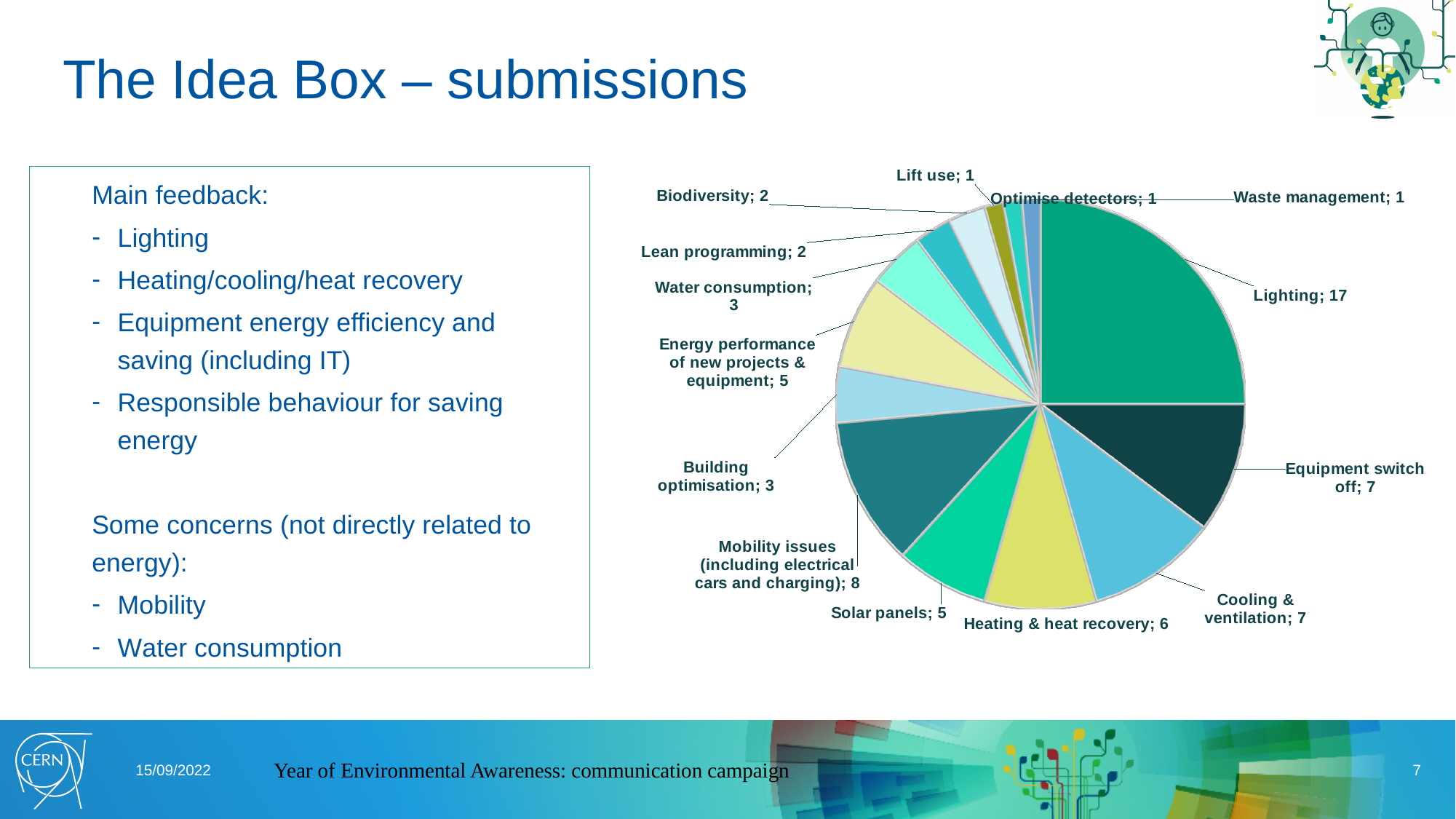
How many submissions are shown for Lighting? 17 What is the value for Mobility issues (including electrical cars and charging)? 8 What type of chart is shown on the slide? pie chart What share of the pie does Lighting represent? 25% Which is larger, the value for Cooling & ventilation or the value for Heating & heat recovery? Cooling & ventilation What is the total of all values shown in the pie chart? 68 How many categories are shown in the pie chart? 14 What is the value for Heating & heat recovery? 6 What is the value for Water consumption? 3 Which category has the largest slice of the pie? Lighting What is the difference between the values for Lighting and Mobility issues (including electrical cars and charging)? 9 What is the difference between the values for Equipment switch off and Solar panels? 2